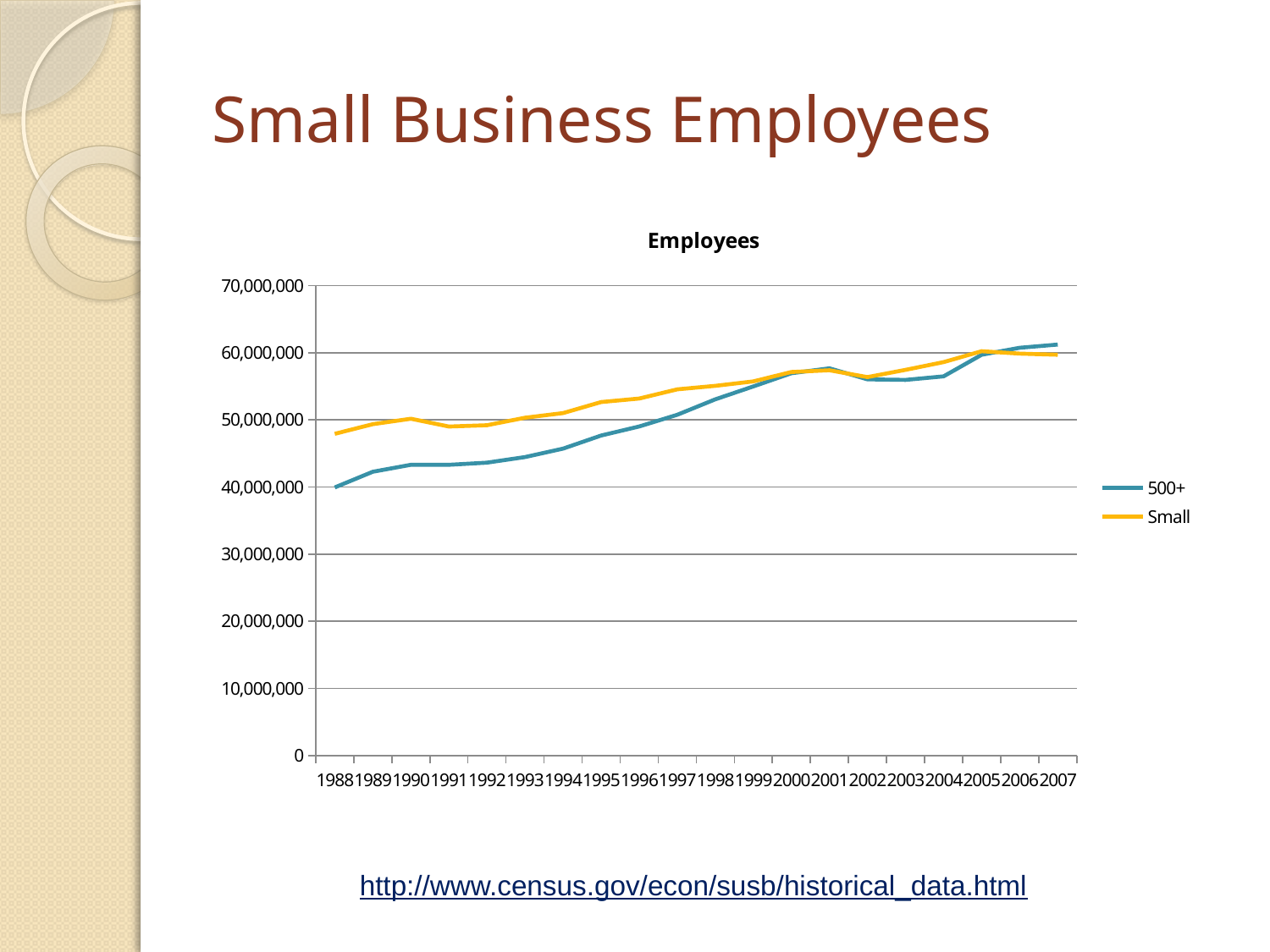
Does the 500+ series generally rise or fall from 1988 to 2007? rise Is the value for Small in 1995 greater or less than 50,000,000? greater How many years are plotted along the x axis of the chart? 20 Which series is drawn in yellow in the chart? Small Is the value for 500+ in 1990 greater or less than 40,000,000? greater What is the title of the chart? Employees In 1993, which series has the larger value, 500+ or Small? Small Is the value for Small in 1988 greater or less than 50,000,000? less What kind of chart is shown on the slide? line chart In 1988, which series has the larger value, 500+ or Small? Small How many series does the chart's legend list? 2